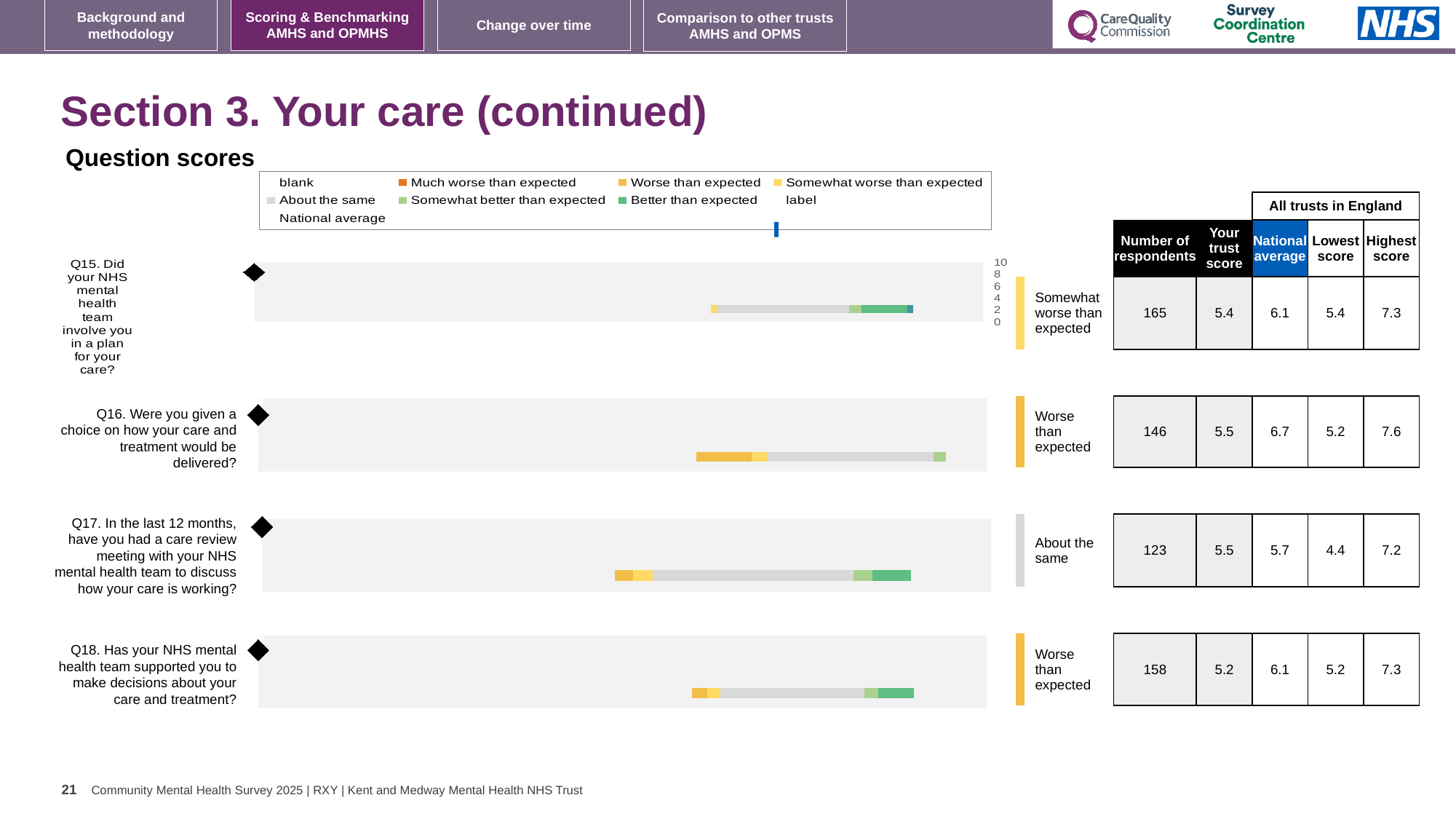
Which question has the highest number of respondents? Q15 Which question has the lowest trust score? Q18 For Q17, which is larger: the trust score or the national average? National average For the Q16 chart, what is the national average shown in the table? 6.7 For Q16, what is the difference between the national average and the trust score? 1.2 What category label is shown next to the Q17 chart? About the same For the Q15 chart, what is the trust's score shown in the table? 5.4 What kind of chart is used to show the question scores for Q15 to Q18? Bar chart For the Q17 chart, how many respondents are shown in the table? 123 In the legend, what colour represents 'Much worse than expected'? Orange For the Q18 chart, what is the highest score across all trusts in England? 7.3 How many questions (Q15 to Q18) have a bar chart on the slide? 4